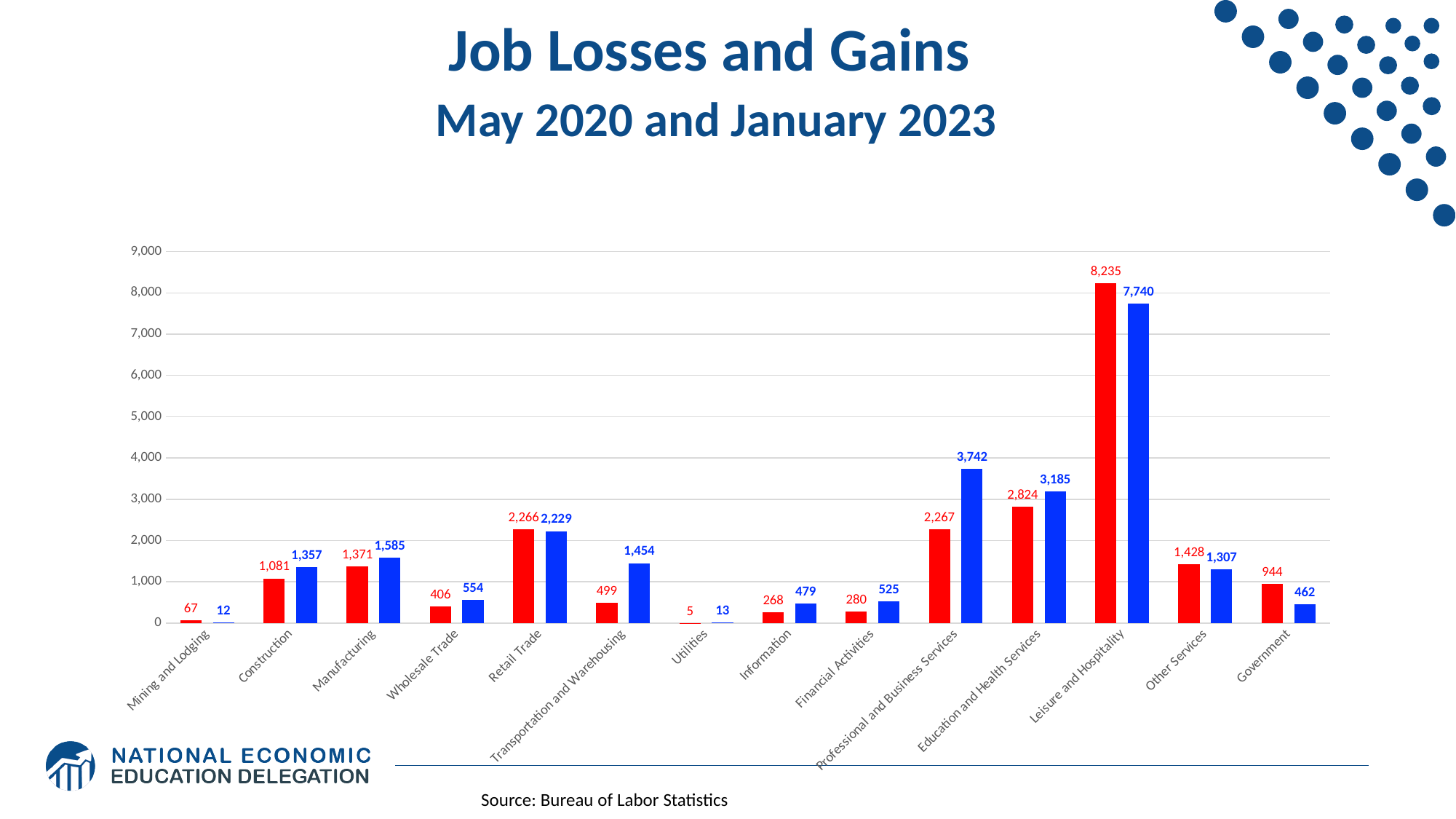
Which category has the lowest blue bar? Mining and Lodging What is the value of the red bar for Leisure and Hospitality? 8,235 What is the source cited for the chart's data? Bureau of Labor Statistics What is the difference between the red bar and the blue bar for Leisure and Hospitality? 495 How many categories are shown on the x axis? 14 What is the value of the blue bar for Government? 462 For Retail Trade, which bar is larger, the red bar or the blue bar? the red bar Which category has the highest red bar? Leisure and Hospitality What is the value of the blue bar for Professional and Business Services? 3,742 What kind of chart is shown on the slide? bar chart Is the value of the blue bar for Education and Health Services greater or less than 3,000? greater What is the difference between the blue bar and the red bar for Construction? 276